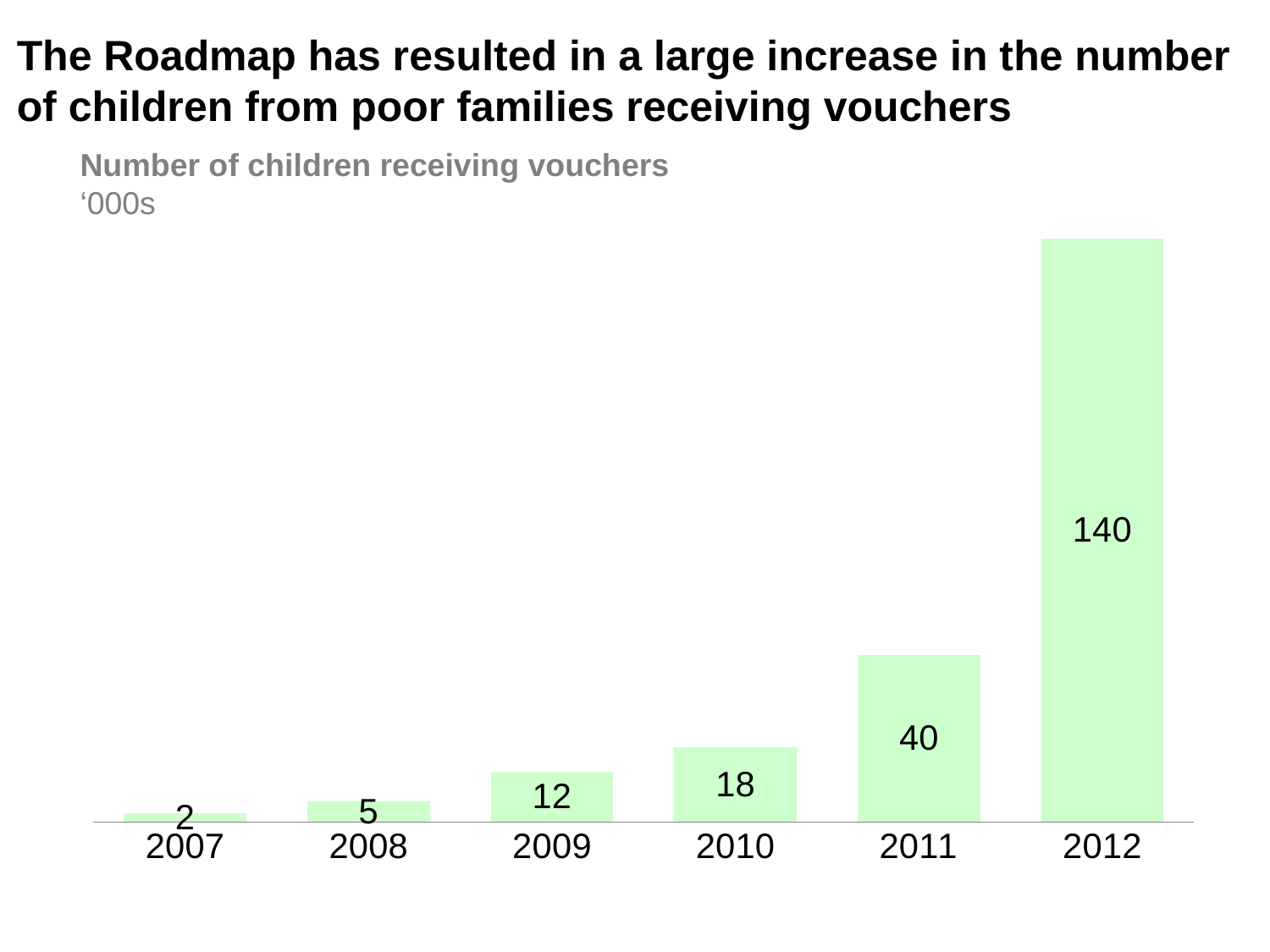
Do the values rise or fall from 2007 to 2012? Rise What is the number of children receiving vouchers ('000s) in 2009? 12 What is the difference between the 2012 and 2011 values? 100 How many years are shown on the chart? 6 What is the number of children receiving vouchers ('000s) in 2012? 140 Which year has the highest number of children receiving vouchers? 2012 What is the number of children receiving vouchers ('000s) in 2007? 2 What kind of chart is shown on the slide? Bar chart Which year has a larger value, 2010 or 2011? 2011 What is the difference between the 2010 and 2008 values? 13 What unit is the chart's data expressed in, according to the subtitle? '000s Which year has the lowest number of children receiving vouchers? 2007